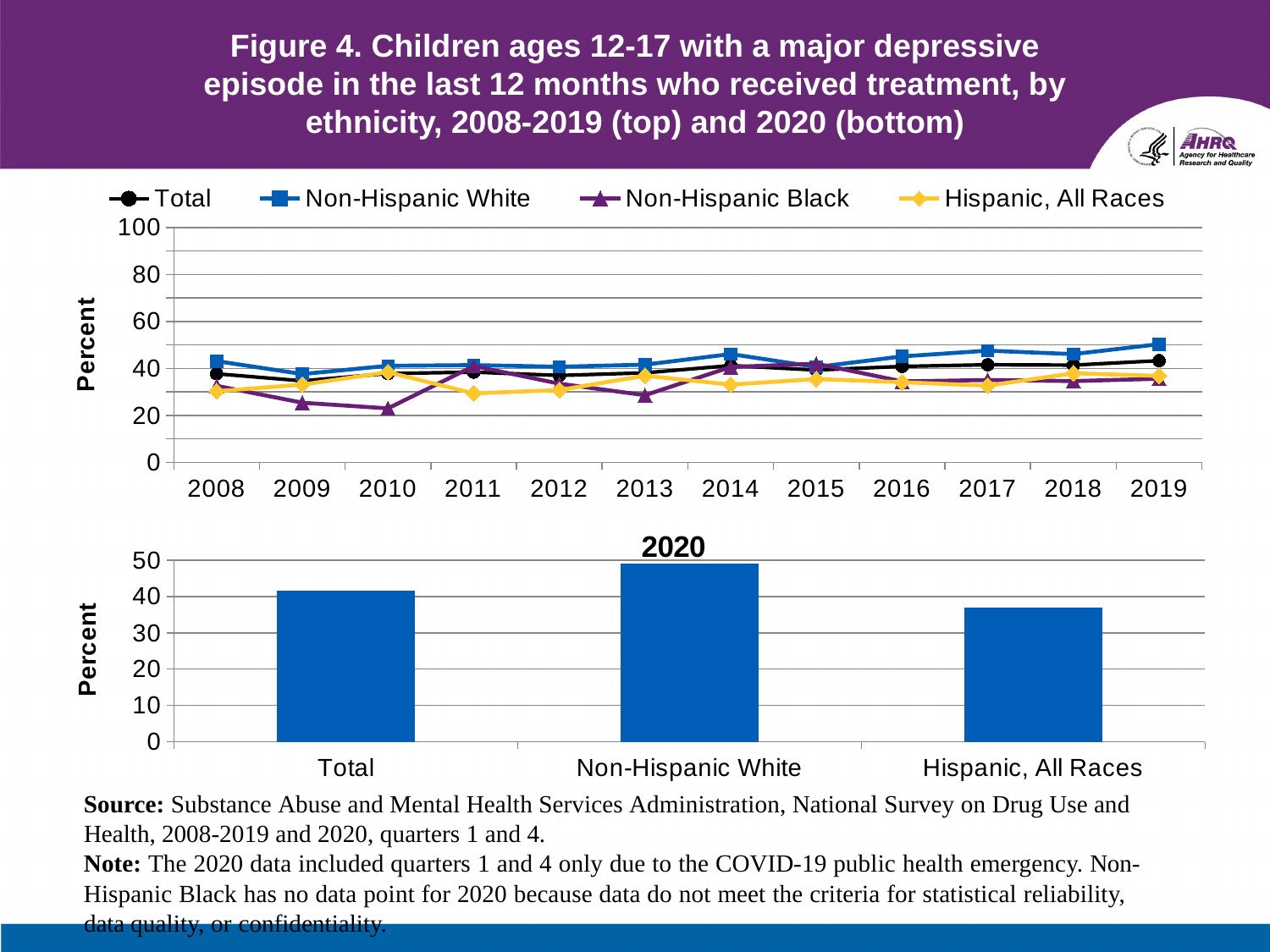
How many series does the legend of the top chart list? 4 What kind of chart is the top chart (2008-2019)? line chart How many years are plotted along the x axis of the top chart? 12 In the top chart, which series is shown with a yellow line and diamond markers? Hispanic, All Races In the bottom chart (2020), is the value for Hispanic, All Races greater or less than 40? less How many bars are shown in the bottom chart (2020)? 3 In the bottom chart (2020), which category has the lowest value? Hispanic, All Races In the top chart, is the value for Non-Hispanic Black in 2010 greater or less than 40? less In the top chart, which is larger in 2010: Non-Hispanic White or Non-Hispanic Black? Non-Hispanic White In the bottom chart (2020), is the value for Non-Hispanic White greater or less than 40? greater In the bottom chart (2020), which category has the highest value? Non-Hispanic White What kind of chart is the bottom chart (2020)? bar chart